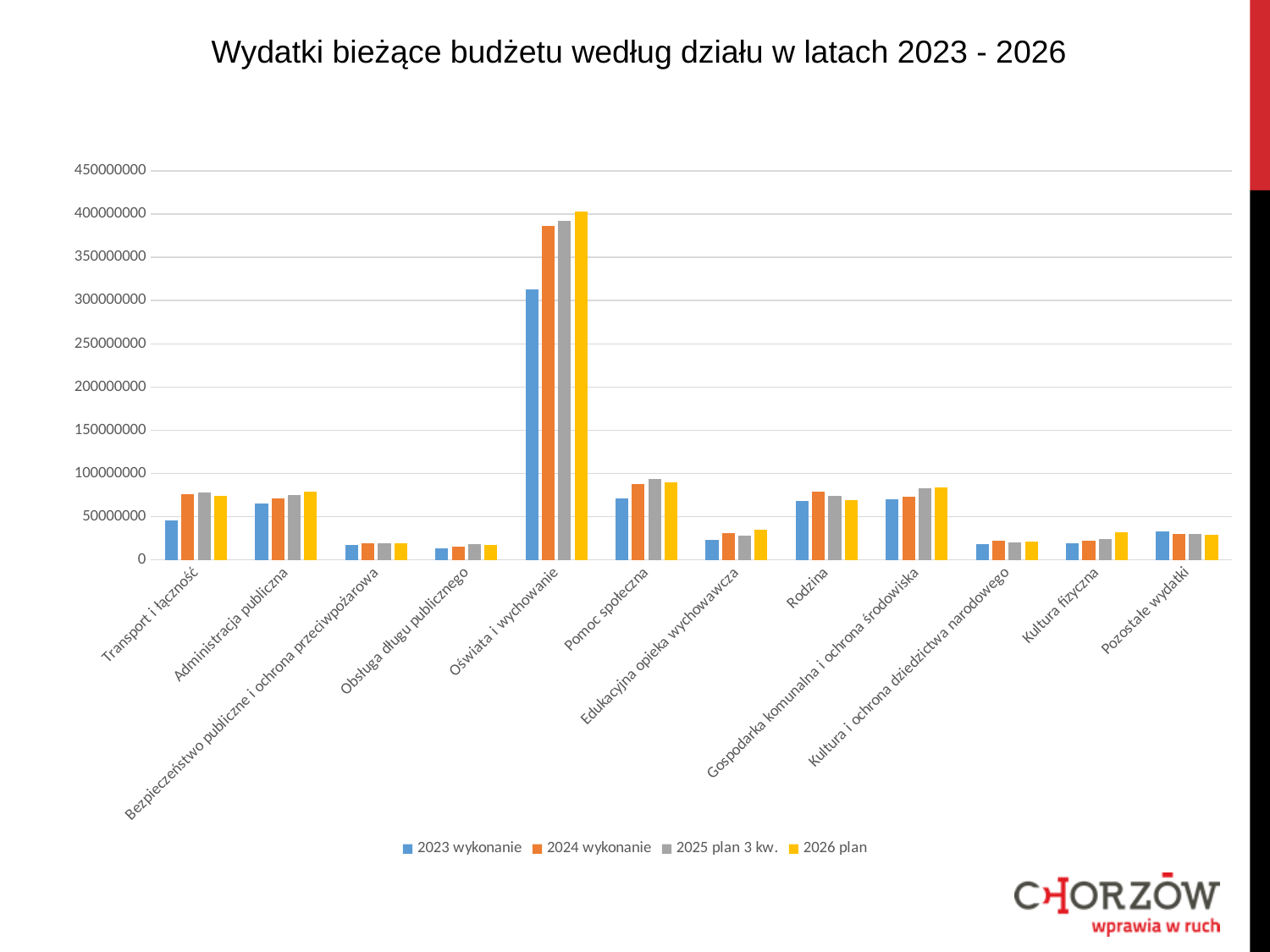
Is the 2024 wykonanie value for Oświata i wychowanie greater or less than 400000000? less How many series does the legend list? 4 Which category has the highest values in the chart? Oświata i wychowanie Is the 2026 plan value for Edukacyjna opieka wychowawcza greater or less than 50000000? less For Rodzina, which is larger: the 2024 wykonanie value or the 2026 plan value? 2024 wykonanie For Oświata i wychowanie, do the values rise or fall from 2023 wykonanie to 2026 plan? rise Is the 2023 wykonanie value for Oświata i wychowanie greater or less than 300000000? greater For Transport i łączność, which is larger: the 2023 wykonanie value or the 2024 wykonanie value? 2024 wykonanie What colour represents the 2026 plan series in the legend? Yellow How many categories (działy) are shown on the x axis? 12 What kind of chart is shown on the slide? Bar chart